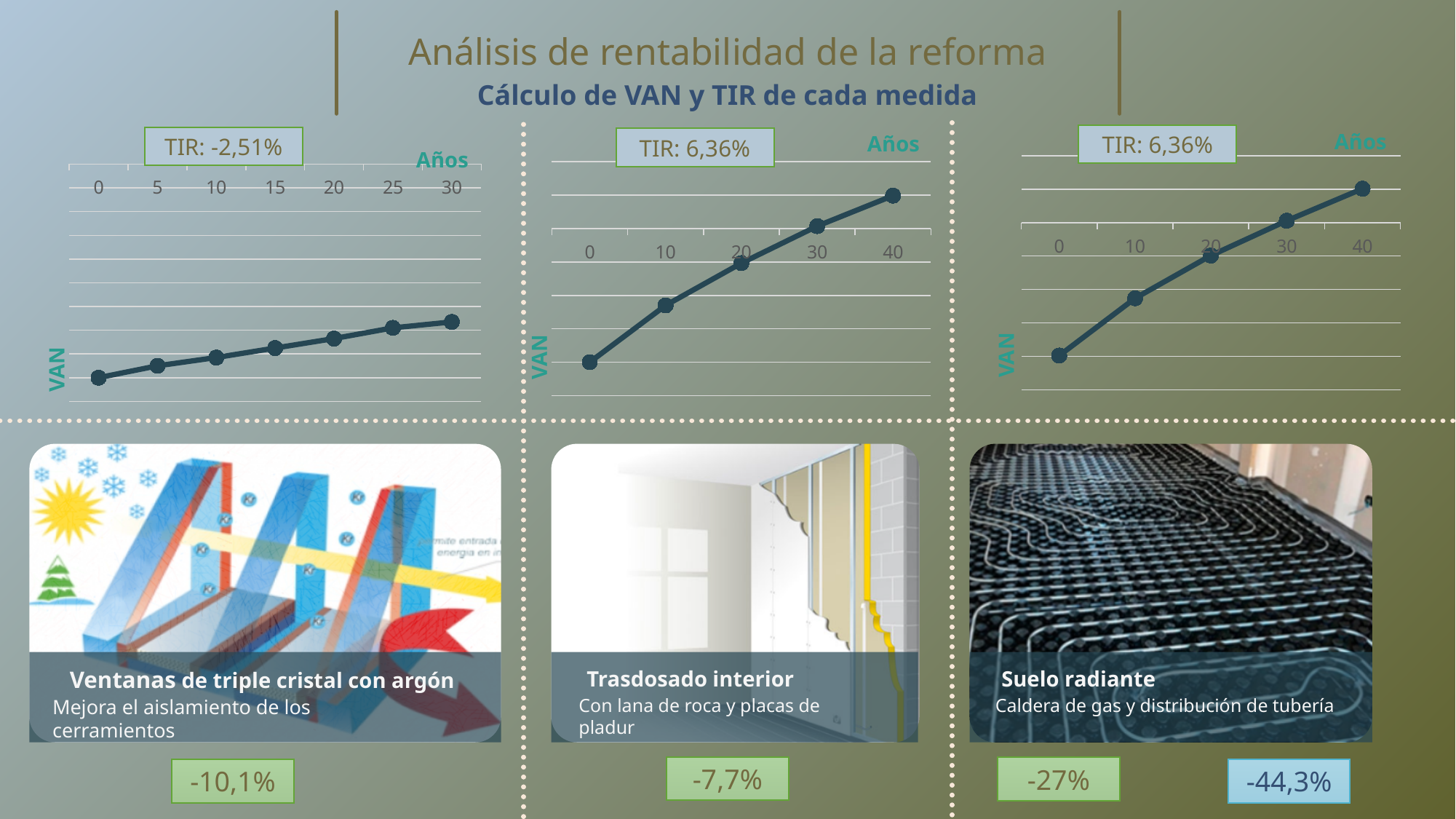
In the left chart, which year has the lowest VAN value? 0 How many data points are plotted on the right chart? 5 What kind of chart is the left chart on the slide? line chart In the middle chart, does the VAN line rise or fall as the years increase? rise How many data points are plotted on the middle chart? 5 How many data points are plotted on the left chart? 7 What label is shown on the x axis of the charts? Años In the right chart, does the VAN line rise or fall as the years increase? rise In the left chart, does the VAN line rise or fall as the years increase? rise What TIR value is shown above the left chart? TIR: -2,51% In the middle chart, is the VAN value at year 40 higher or lower than at year 0? higher